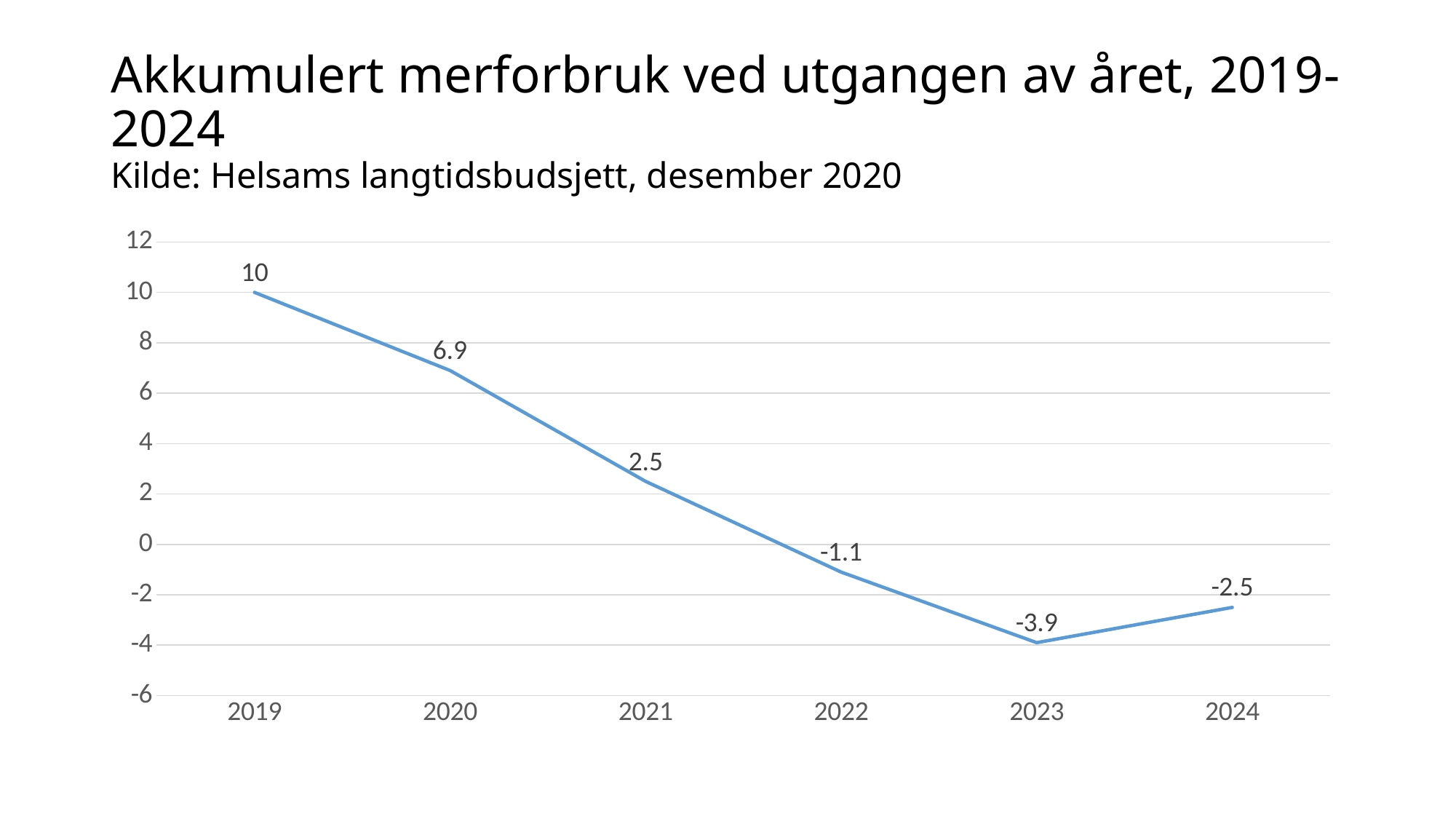
Which is larger, the value for 2022 or the value for 2024? 2022 Is the value for 2020 greater or less than 6? greater Which year has the highest value? 2019 What is the value for 2024? -2.5 How many years are plotted on the chart? 6 What kind of chart is shown on the slide? line chart Do the values rise or fall from 2019 to 2023? fall What is the difference between the values for 2019 and 2020? 3.1 What is the value for 2019? 10 What is the value for 2021? 2.5 What is the value for 2023? -3.9 Which year has the lowest value? 2023